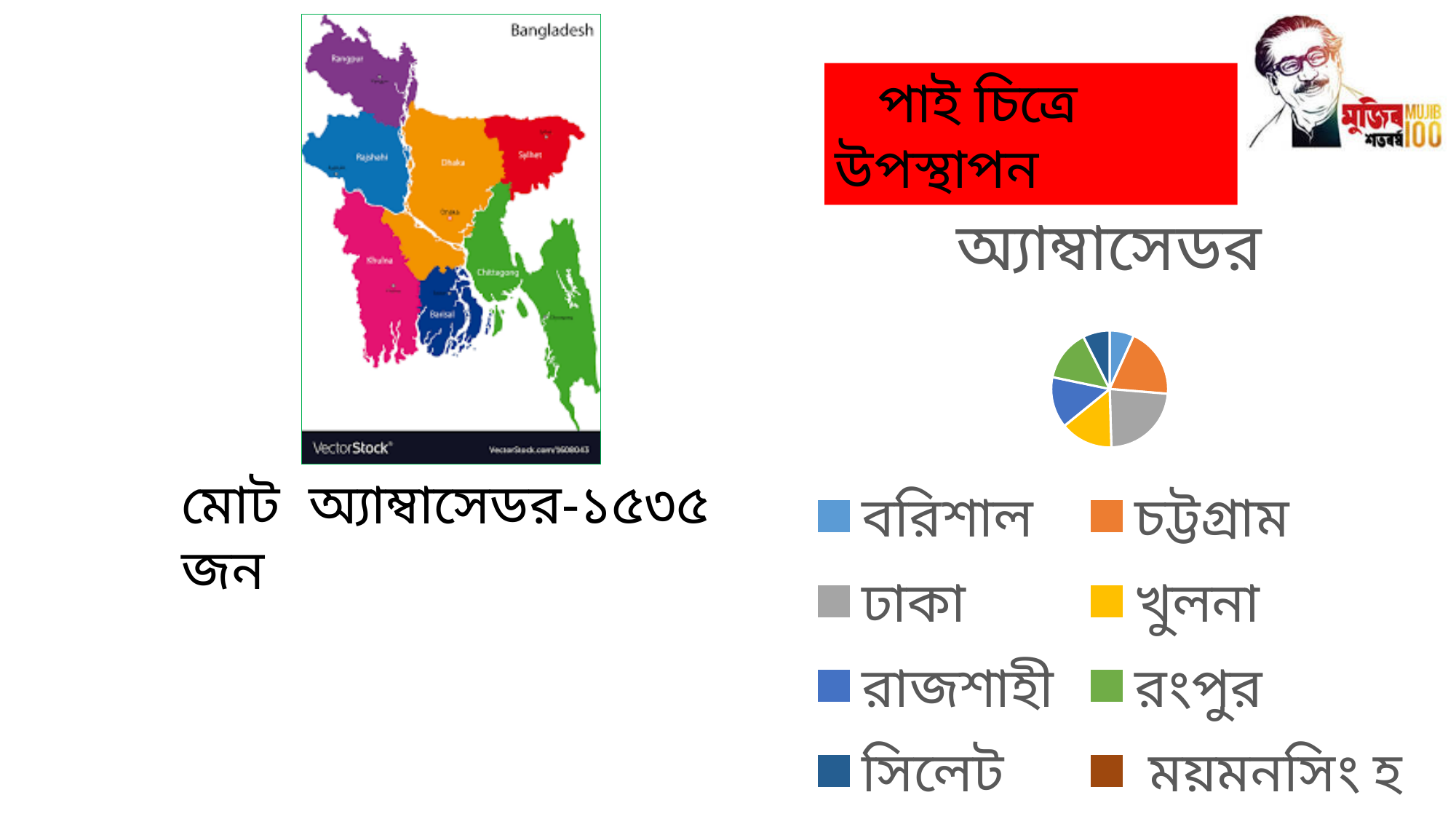
In the pie chart, which is larger, the slice for ঢাকা or the slice for সিলেট? ঢাকা Which colour represents ঢাকা in the pie chart legend? gray In the pie chart, which is larger, the slice for চট্টগ্রাম or the slice for বরিশাল? চট্টগ্রাম What kind of chart is shown on the slide? pie chart What is the title of the pie chart? অ্যাম্বাসেডর In the pie chart, which is larger, the slice for রংপুর or the slice for বরিশাল? রংপুর How many entries does the legend of the pie chart list? 8